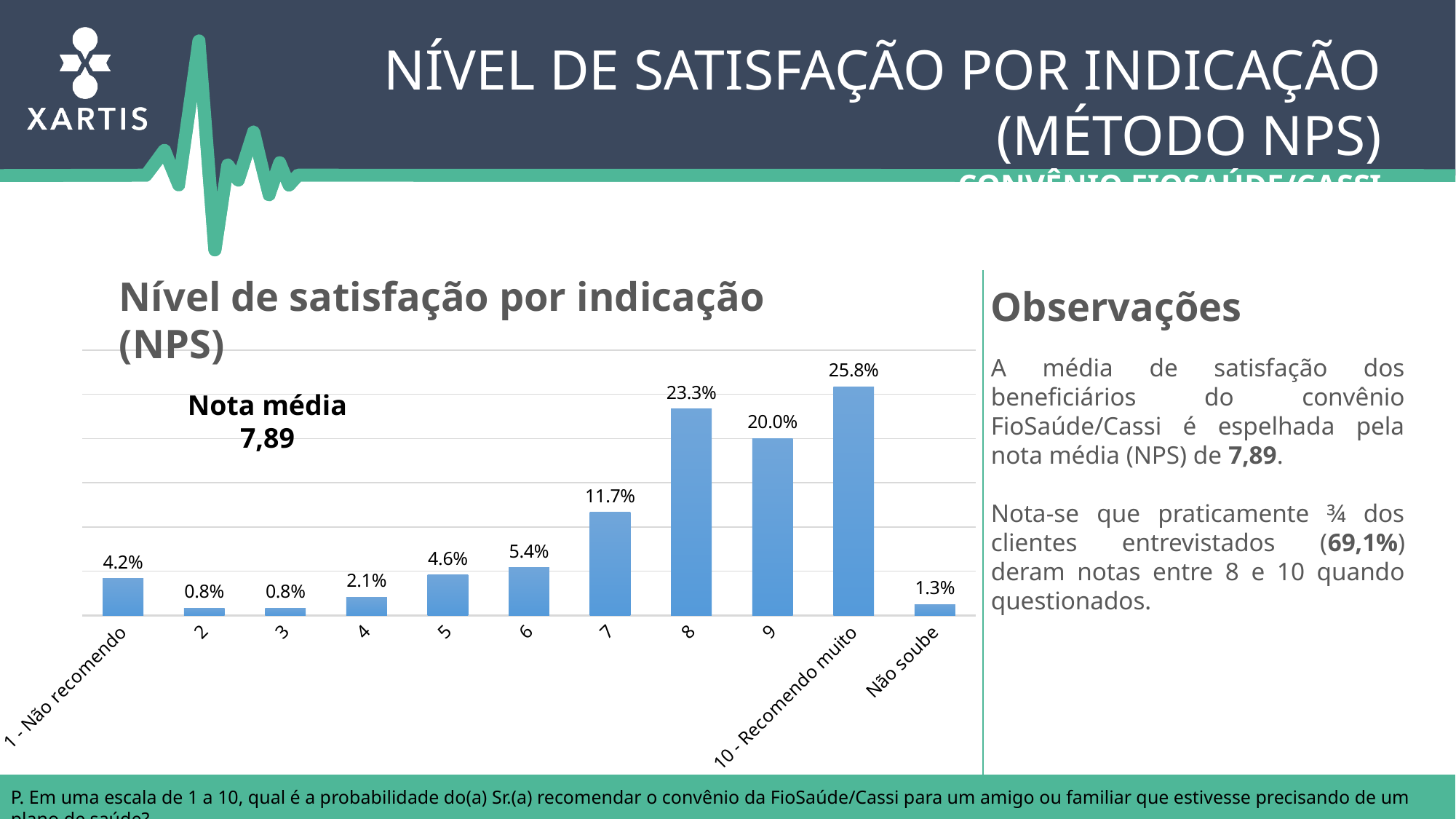
What is the difference between the values for score 8 and score 9? 3.3% What kind of chart is shown on the slide? bar chart What is the "Nota média" shown on the chart? 7,89 How many categories are shown on the x axis? 11 What is the title of the chart? Nível de satisfação por indicação (NPS) Which is larger, the value for score 5 or the value for score 6? score 6 Which category has the highest value? 10 - Recomendo muito What is the value for the category "Não soube"? 1.3% What is the value for the category "1 - Não recomendo"? 4.2% Which is larger, the value for score 8 or the value for score 9? score 8 What is the value for score 7? 11.7% What is the value for the category "10 - Recomendo muito"? 25.8%